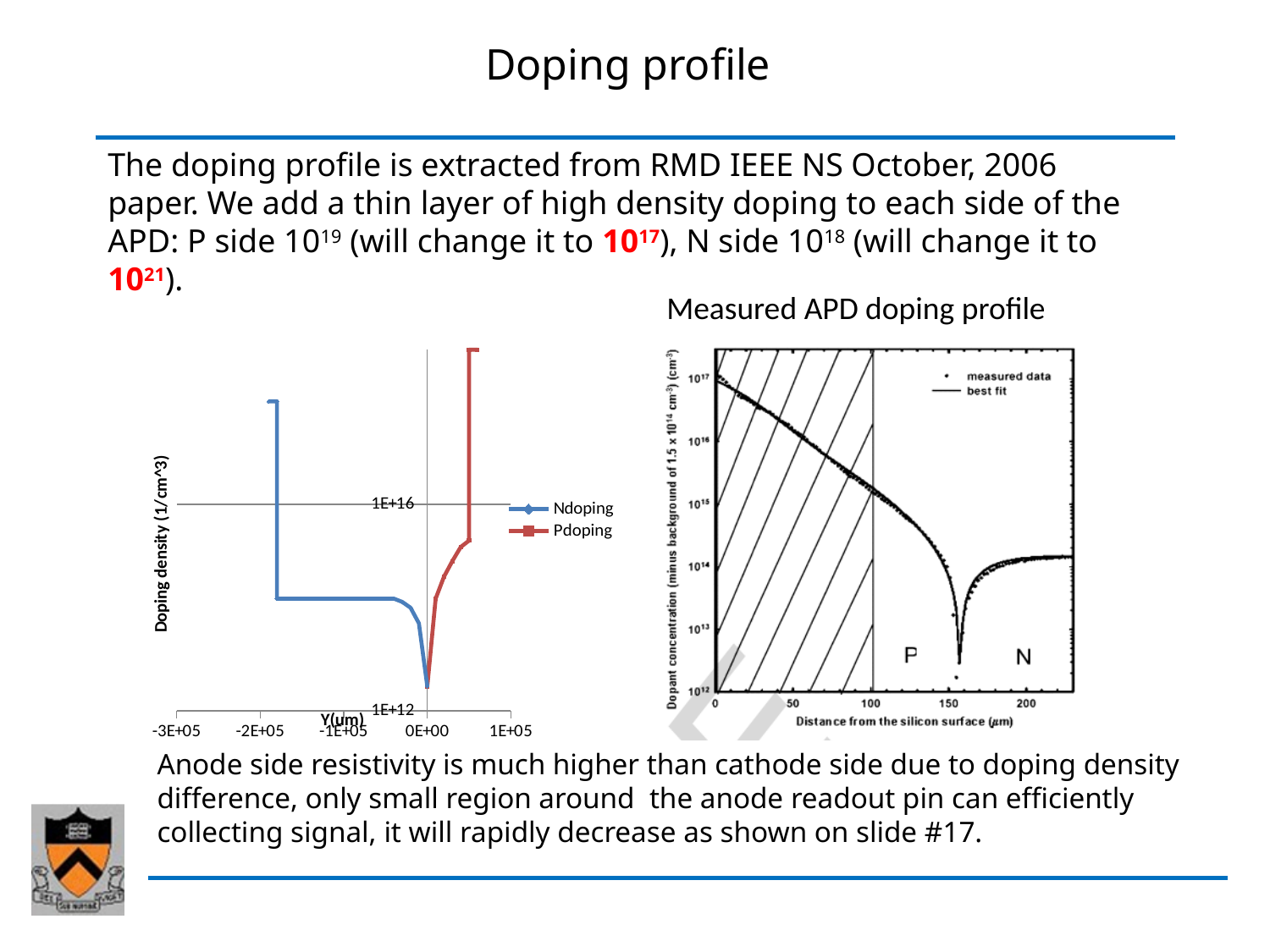
On the right chart titled 'Measured APD doping profile', is the dopant concentration at distance 50 μm greater or less than 10^15? greater On the right chart titled 'Measured APD doping profile', how many series does the legend list? 2 On the right chart titled 'Measured APD doping profile', which region label appears to the right of the minimum, P or N? N On the right chart titled 'Measured APD doping profile', is the dopant concentration at distance 200 μm greater or less than 10^15? less On the right chart titled 'Measured APD doping profile', does the dopant concentration rise or fall as distance increases from 0 to 150 μm? fall On the left chart, which series is drawn in blue? Ndoping On the left chart, what kind of chart is shown? line chart On the left chart, does the Ndoping series lie on the negative or positive side of the Y(um) axis? negative On the left chart, how many series does the legend list? 2 On the right chart titled 'Measured APD doping profile', is the dopant concentration at distance 0 greater or less than 10^16? greater On the left chart, what is the label of the vertical axis? Doping density (1/cm^3)